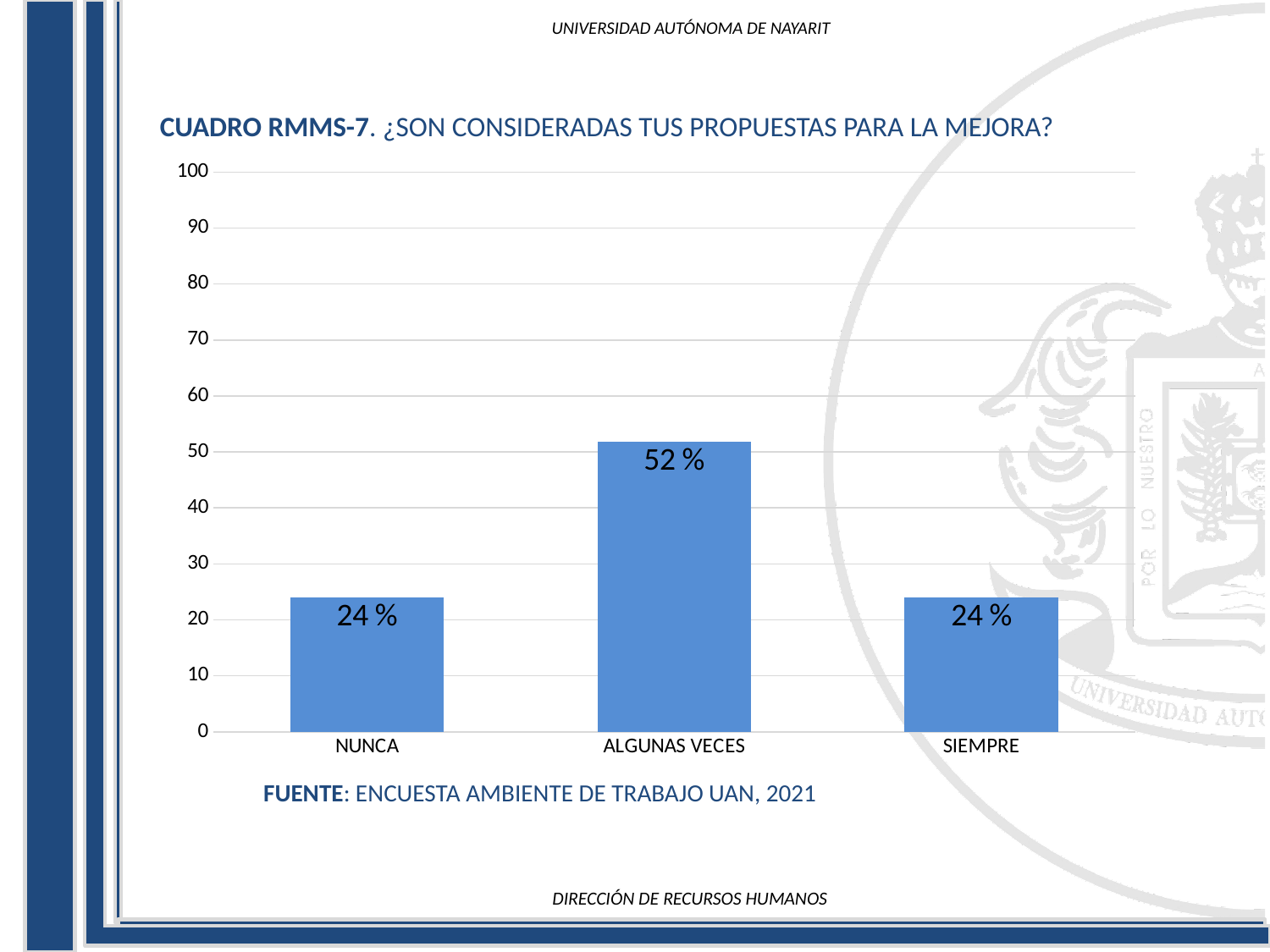
Which is larger, the value for ALGUNAS VECES or the value for SIEMPRE? ALGUNAS VECES What is the value for ALGUNAS VECES? 52 % What is the value for NUNCA? 24 % What is the difference between the values for ALGUNAS VECES and NUNCA? 28 % What is the value for SIEMPRE? 24 % What is the title of the chart? CUADRO RMMS-7. ¿SON CONSIDERADAS TUS PROPUESTAS PARA LA MEJORA? How many categories are shown on the x axis? 3 Is the value for NUNCA greater or less than 30? less What kind of chart is shown on the slide? bar chart Is the value for ALGUNAS VECES greater or less than 50? greater Which category has the highest value? ALGUNAS VECES What source is cited below the chart? ENCUESTA AMBIENTE DE TRABAJO UAN, 2021